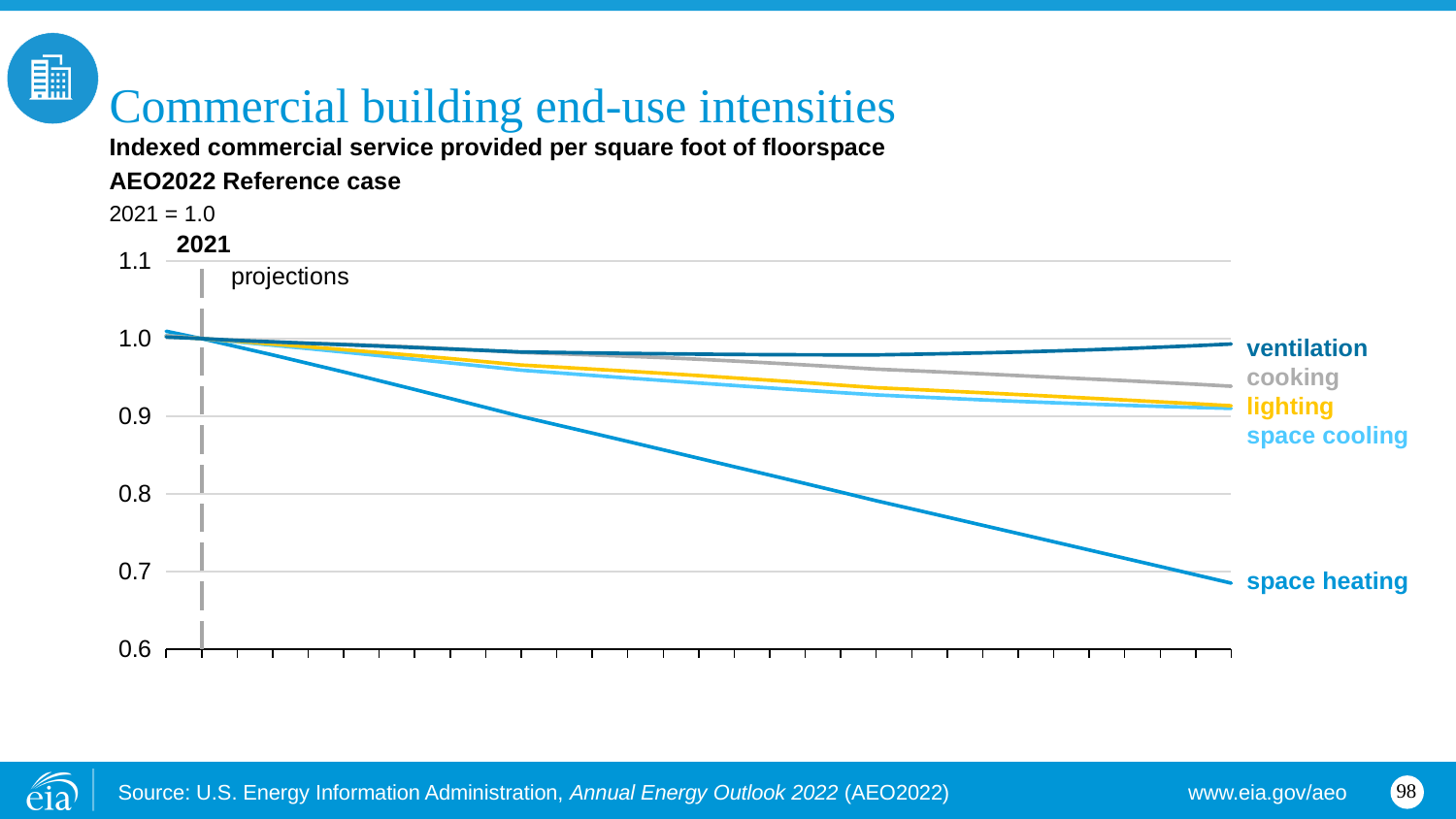
Which series has the lowest value at the end of the projection period? space heating What kind of chart is shown on the slide? line chart Which series has the highest value at the end of the projection period? ventilation Is the value for space heating at the end of the projection period greater or less than 0.8? less Does the space heating series rise or fall over the projection period? fall At the end of the projection period, which is larger: cooking or lighting? cooking At the end of the projection period, which is larger: ventilation or space heating? ventilation Is the value for ventilation at the end of the projection period greater or less than 0.9? greater What is the indexed value of every series in 2021? 1.0 Is the value for cooking at the end of the projection period greater or less than 0.9? greater How many series are labeled on the chart? 5 What is the title of the chart? Commercial building end-use intensities